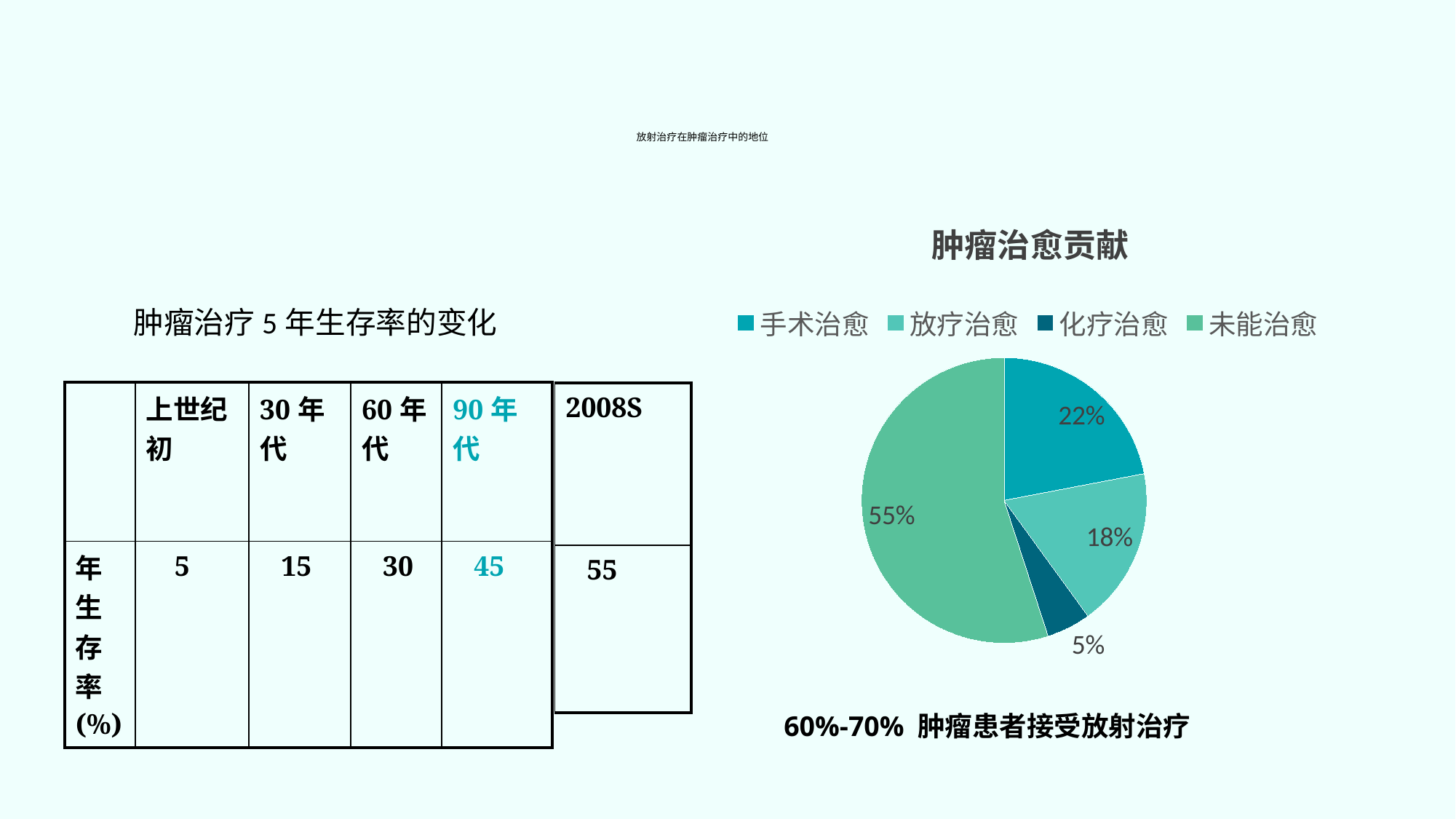
In the pie chart 肿瘤治愈贡献, what share is labelled for 化疗治愈? 5% In the pie chart 肿瘤治愈贡献, what share is labelled for 未能治愈? 55% In the pie chart 肿瘤治愈贡献, what is the difference between the shares for 未能治愈 and 化疗治愈? 50% In the pie chart 肿瘤治愈贡献, what is the difference between the shares for 手术治愈 and 放疗治愈? 4% In the pie chart 肿瘤治愈贡献, what share is labelled for 手术治愈? 22% In the pie chart 肿瘤治愈贡献, which category has the largest slice? 未能治愈 What kind of chart is shown under the title 肿瘤治愈贡献? Pie chart In the pie chart 肿瘤治愈贡献, which is larger, 手术治愈 or 放疗治愈? 手术治愈 How many slices does the pie chart 肿瘤治愈贡献 have? 4 How many entries does the legend of the pie chart 肿瘤治愈贡献 list? 4 In the pie chart 肿瘤治愈贡献, which category has the smallest slice? 化疗治愈 In the pie chart 肿瘤治愈贡献, what share is labelled for 放疗治愈? 18%